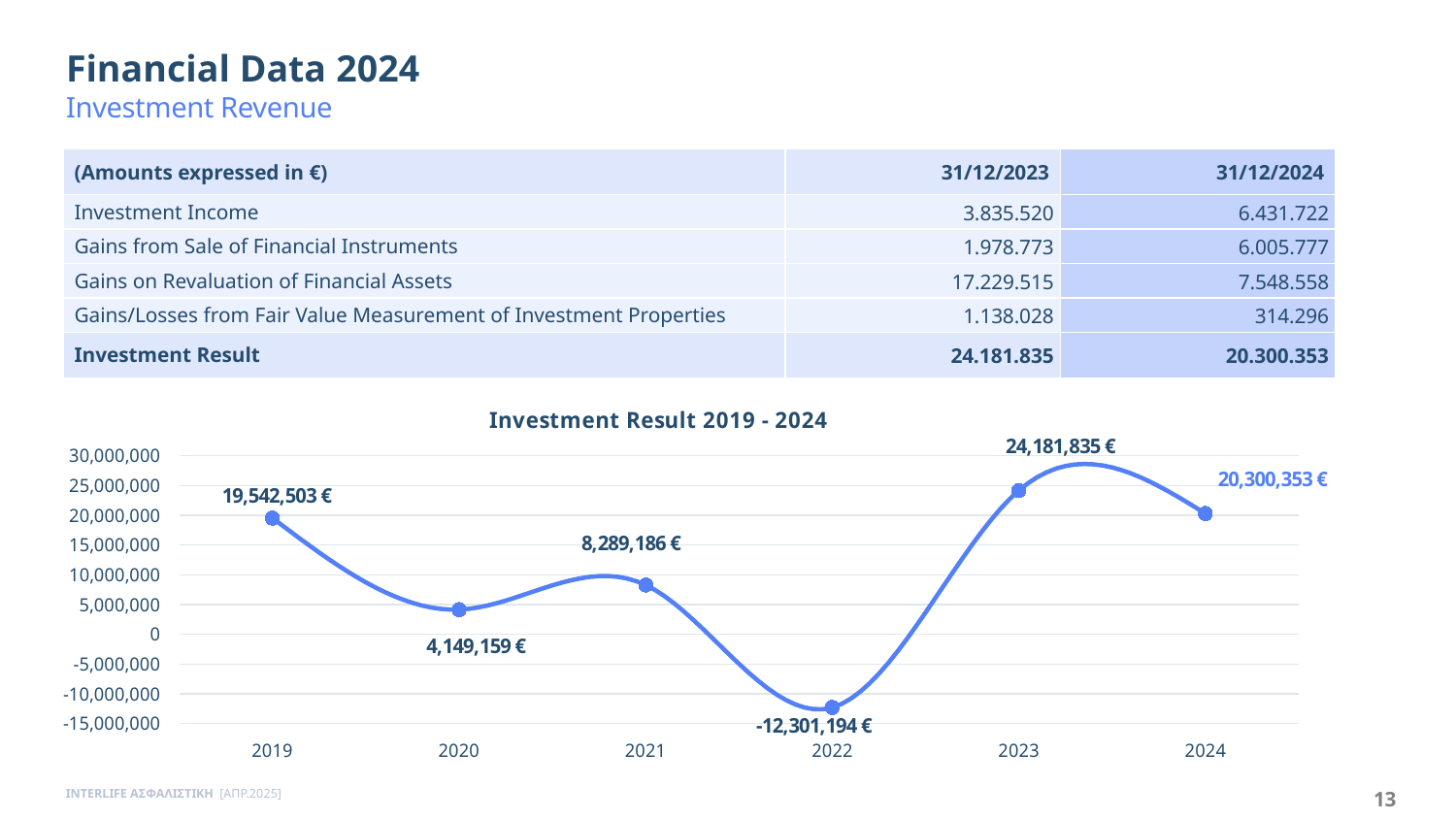
What is the Investment Result for 2020 in the chart? 4,149,159 € What is the Investment Result for 2023 in the chart? 24,181,835 € What is the difference between the Investment Result for 2023 and 2024? 3,881,482 € What is the Investment Result for 2022 in the chart? -12,301,194 € Is the Investment Result for 2024 greater or less than 15,000,000? greater What kind of chart is shown on the slide? line chart Which year has the highest Investment Result in the chart? 2023 How many years are plotted in the chart? 6 Which year has the lowest Investment Result in the chart? 2022 What is the difference between the Investment Result for 2019 and 2020? 15,393,344 € Which year has a larger Investment Result, 2019 or 2021? 2019 Does the Investment Result rise or fall from 2022 to 2023? rise